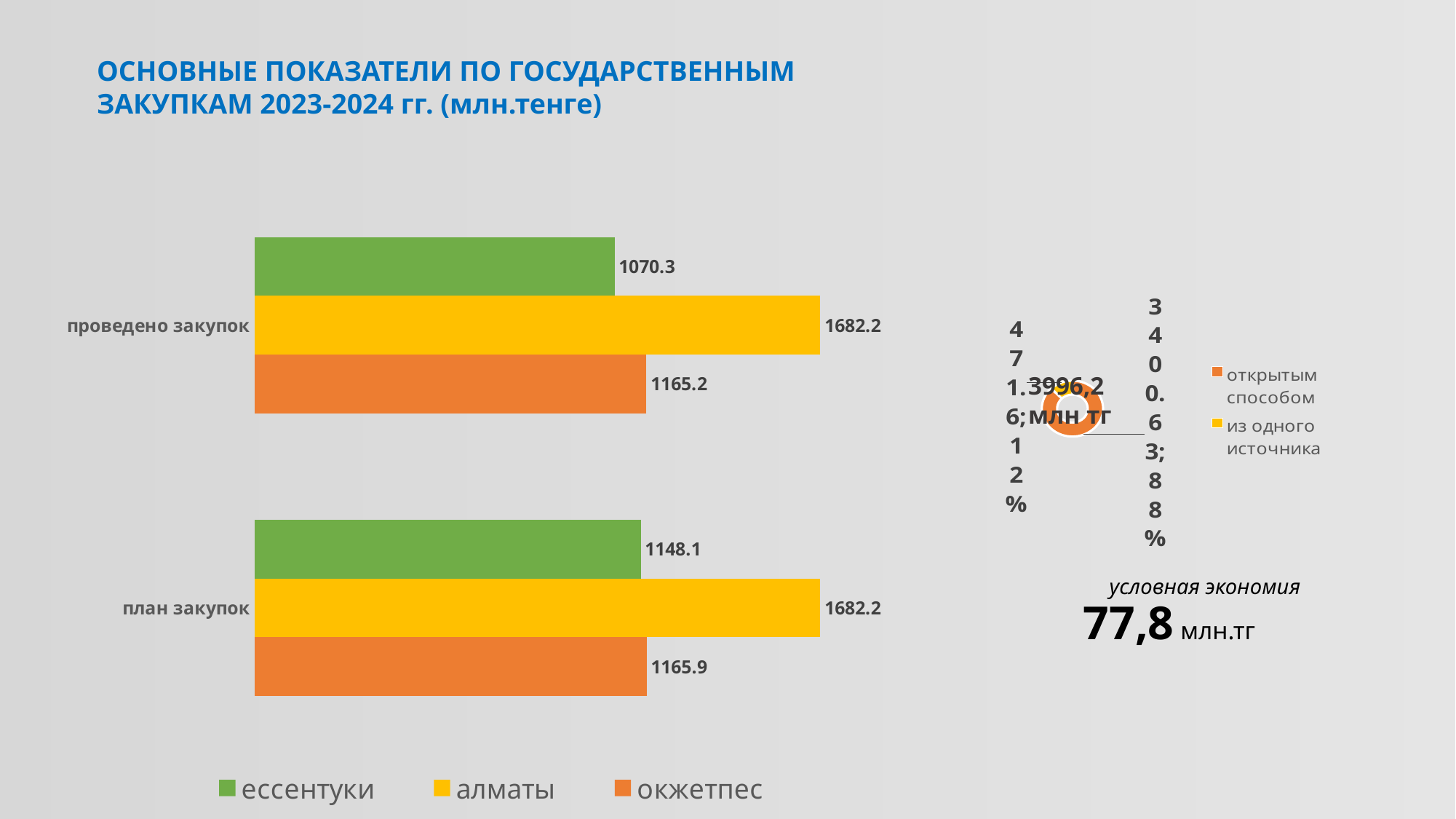
In the bar chart on the left, what is the difference between the 'план закупок' and 'проведено закупок' values for ессентуки? 77.8 In the bar chart on the left, what is the value for окжетпес in the 'проведено закупок' category? 1165.2 What type of chart is the chart on the left of the slide? bar chart In the bar chart on the left, how many series does the legend list? 3 In the bar chart on the left, what is the value for ессентуки in the 'план закупок' category? 1148.1 In the bar chart on the left, which series has the lowest value in the 'план закупок' category? ессентуки In the doughnut chart on the right, how many entries does the legend list? 2 In the bar chart on the left, what is the value for окжетпес in the 'план закупок' category? 1165.9 In the bar chart on the left, what is the value for алматы in the 'проведено закупок' category? 1682.2 In the bar chart on the left, which series has the highest value in the 'проведено закупок' category? алматы In the bar chart on the left, how many categories are shown on the axis? 2 In the bar chart on the left, which is larger for ессентуки: 'проведено закупок' or 'план закупок'? план закупок